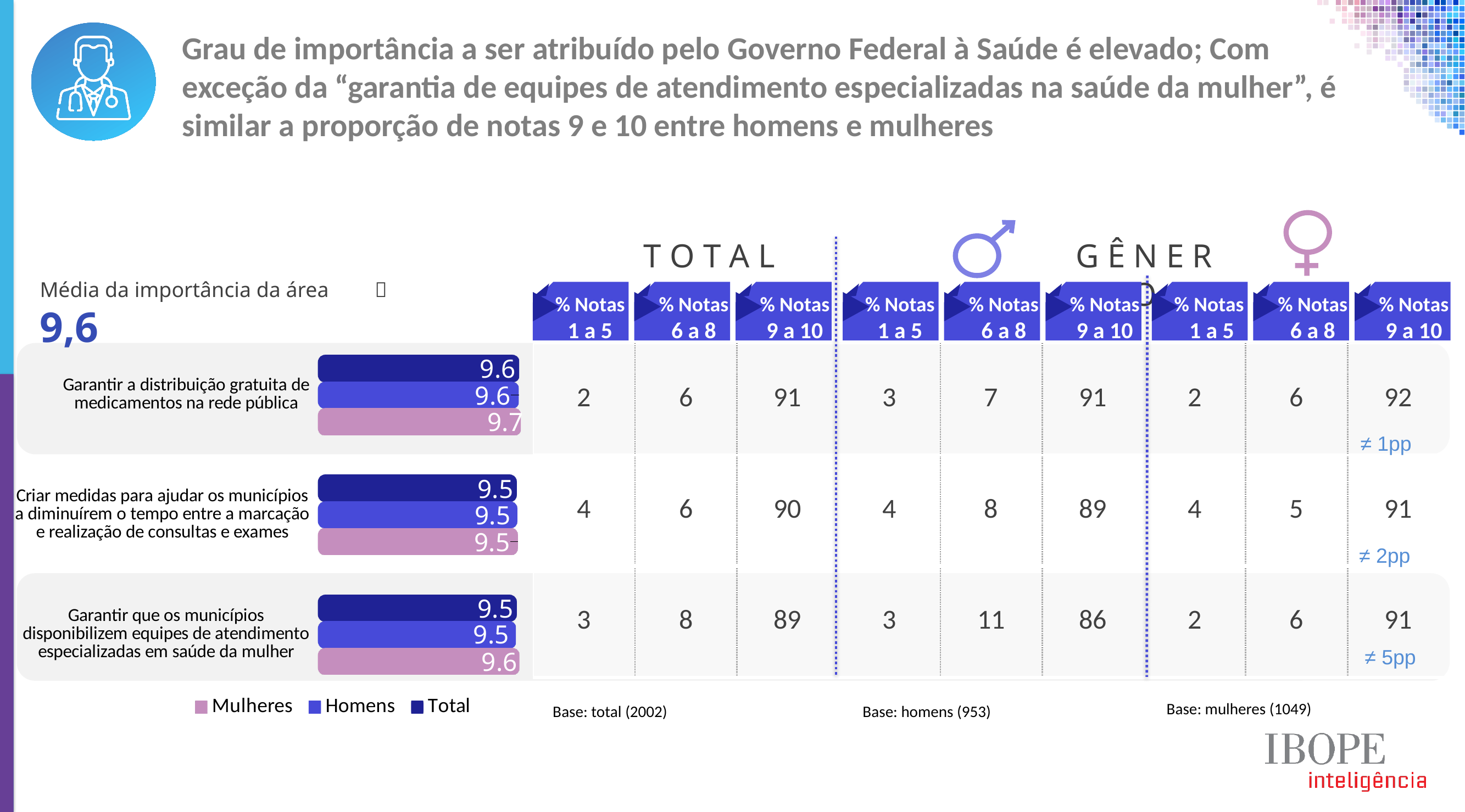
What colour represents the Mulheres series in the bar chart legend? pink How many series does the legend of the bar chart list? 3 How many categories (areas) are shown in the bar chart? 3 What is the value shown for "Média da importância da área" on the slide? 9,6 In the bar chart, what is the Mulheres value for "Garantir a distribuição gratuita de medicamentos na rede pública"? 9.7 What kind of chart is used to show the average importance scores on the slide? bar chart In the bar chart, for "Garantir que os municípios disponibilizem equipes de atendimento especializadas em saúde da mulher", which is larger: the Mulheres value or the Homens value? Mulheres In the bar chart, which category has the highest Mulheres value? Garantir a distribuição gratuita de medicamentos na rede pública In the bar chart, what is the Total value for "Criar medidas para ajudar os municípios a diminuírem o tempo entre a marcação e realização de consultas e exames"? 9.5 In the bar chart, what is the difference between the Mulheres and Total values for "Garantir a distribuição gratuita de medicamentos na rede pública"? 0.1 In the bar chart, what is the Homens value for "Garantir que os municípios disponibilizem equipes de atendimento especializadas em saúde da mulher"? 9.5 In the bar chart, what is the Total value for "Garantir a distribuição gratuita de medicamentos na rede pública"? 9.6